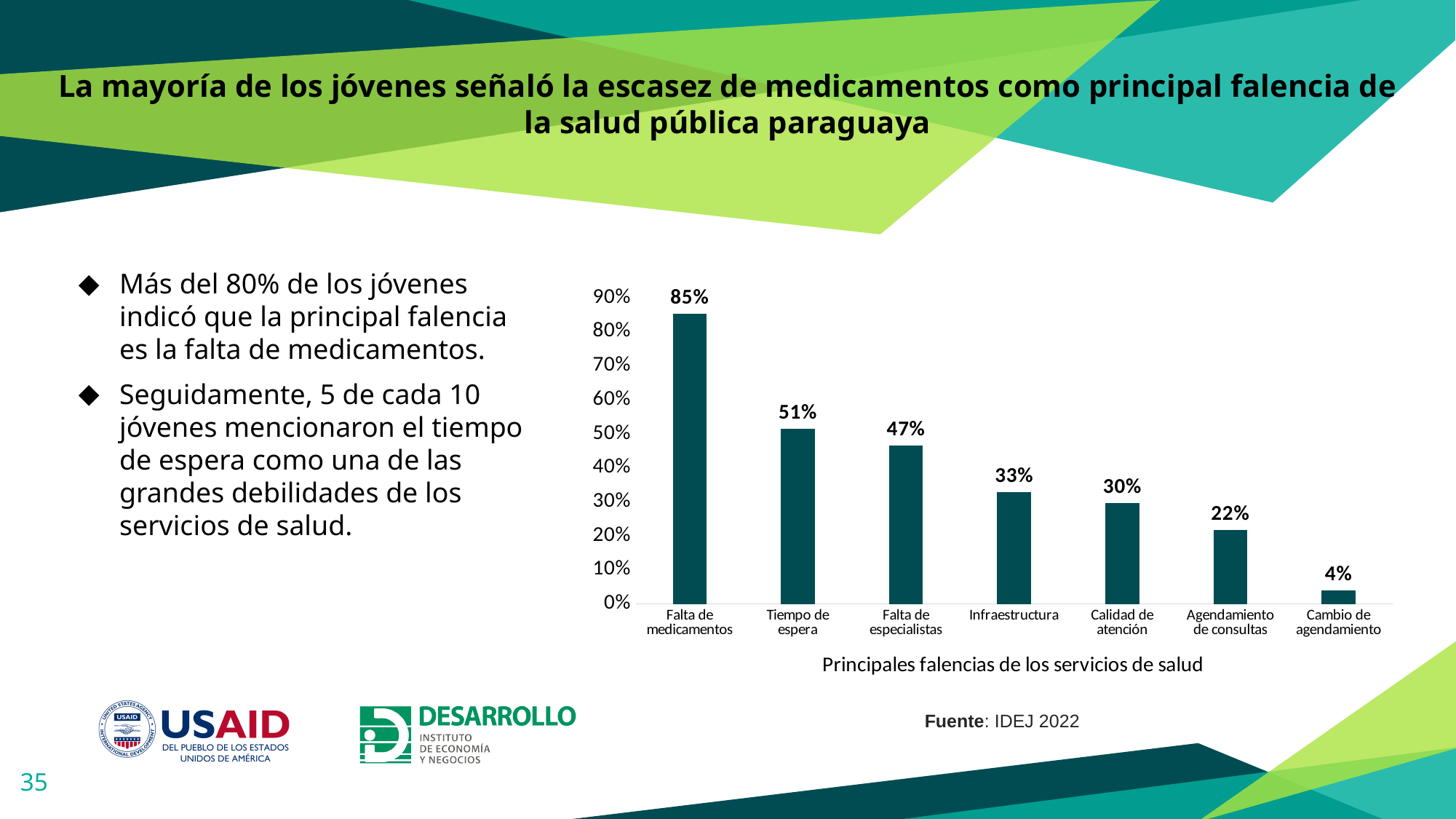
What is the value for Infraestructura? 33% Which is larger, Falta de especialistas or Infraestructura? Falta de especialistas Which category has the highest value? Falta de medicamentos What is the difference between Falta de medicamentos and Tiempo de espera? 34% What is the value for Falta de medicamentos? 85% Which category has the lowest value? Cambio de agendamiento What is the value for Tiempo de espera? 51% What is the difference between Calidad de atención and Agendamiento de consultas? 8% What is the x-axis title of the chart? Principales falencias de los servicios de salud What kind of chart is shown on the slide? Bar chart What is the value for Cambio de agendamiento? 4% How many categories are shown in the chart? 7